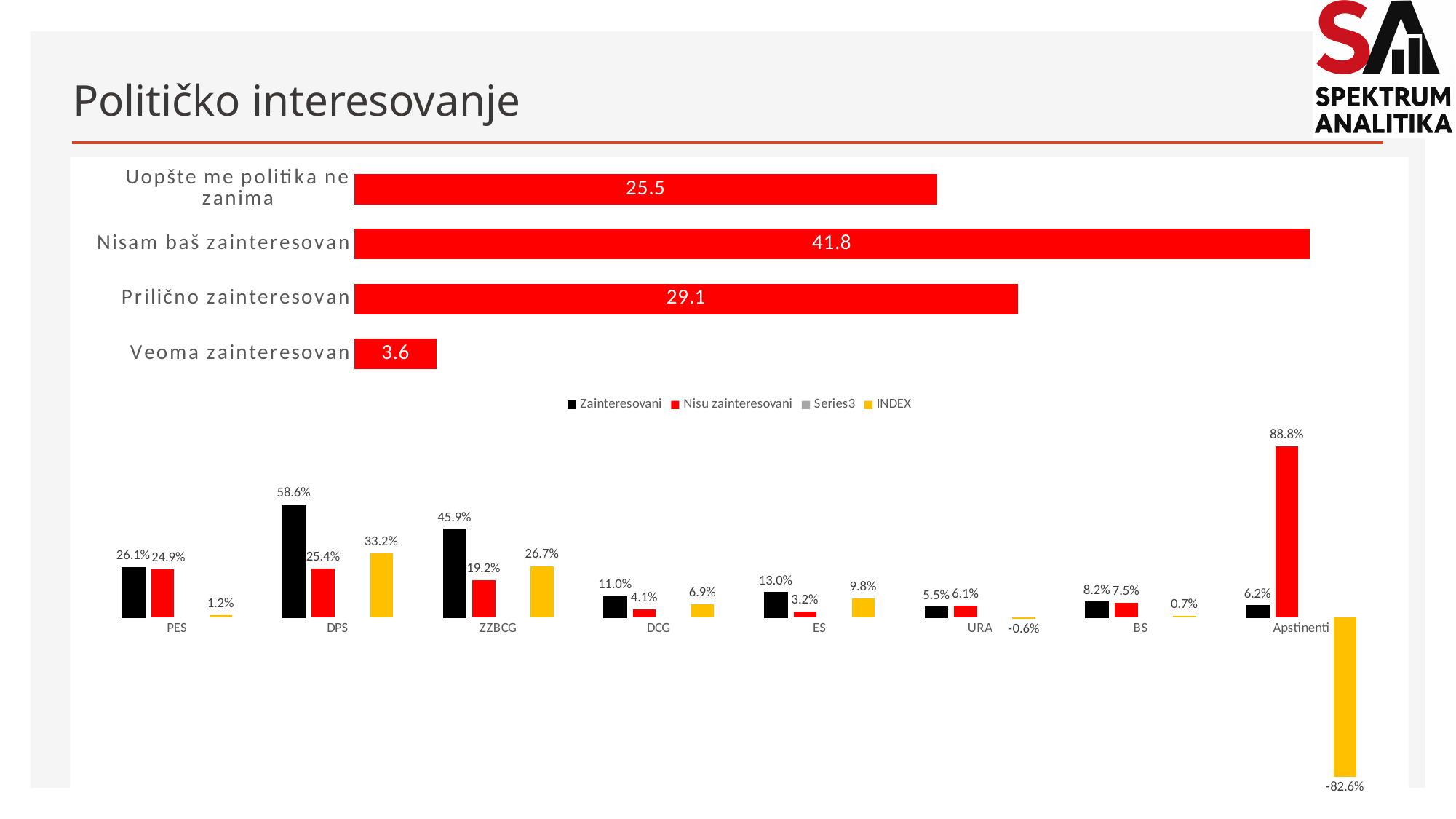
In the bottom chart, what is the INDEX value for Apstinenti? -82.6% In the top chart, which category has the highest value? Nisam baš zainteresovan In the bottom chart, what is the Zainteresovani value for DPS? 58.6% In the bottom chart, which is larger for ZZBCG: Zainteresovani or Nisu zainteresovani? Zainteresovani What kind of chart is the top chart? Bar chart In the top chart, which category has the lowest value? Veoma zainteresovan How many series does the legend of the bottom chart list? 4 How many categories does the top chart show? 4 In the top chart, what is the value for "Nisam baš zainteresovan"? 41.8 In the bottom chart, what is the difference between the Zainteresovani and Nisu zainteresovani values for DCG? 6.9% In the bottom chart, which category has the highest Nisu zainteresovani value? Apstinenti In the top chart, what is the difference between "Prilično zainteresovan" and "Uopšte me politika ne zanima"? 3.6